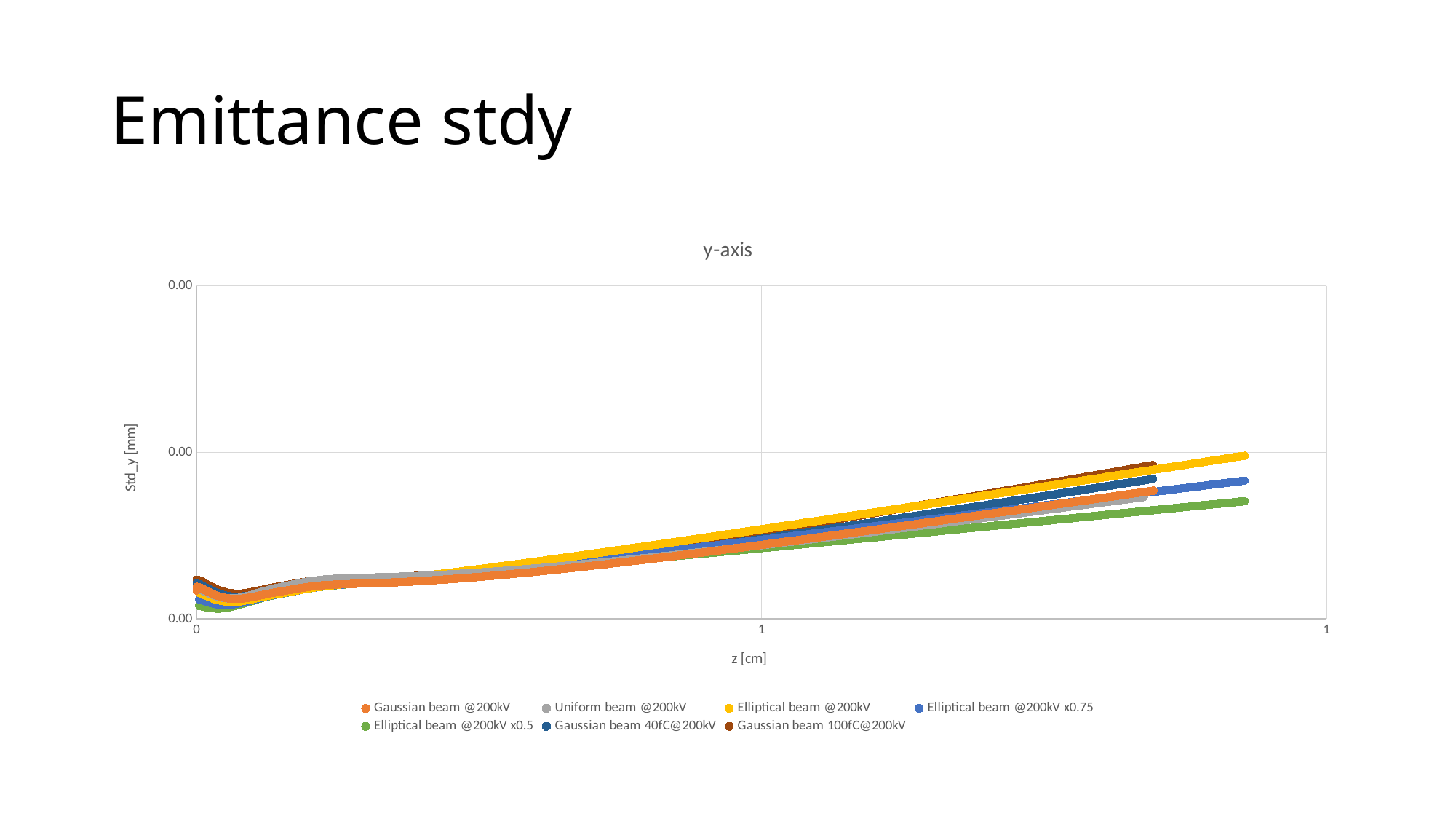
Do the Std_y values generally rise or fall as z increases along the x axis? rise At the right end of the chart, which series is higher: Elliptical beam @200kV or Elliptical beam @200kV x0.5? Elliptical beam @200kV At the right end of the chart, which series is higher: Gaussian beam 100fC@200kV or Gaussian beam @200kV? Gaussian beam 100fC@200kV What is the label of the horizontal axis? z [cm] What is the title of the chart? y-axis Which series reaches the highest Std_y value at the right end of the chart? Elliptical beam @200kV At the right end of the chart, which series is higher: Elliptical beam @200kV x0.75 or Elliptical beam @200kV x0.5? Elliptical beam @200kV x0.75 What kind of chart is shown on the slide? line chart Which series has the lowest Std_y value at the right end of the chart? Elliptical beam @200kV x0.5 How many series does the legend list? 7